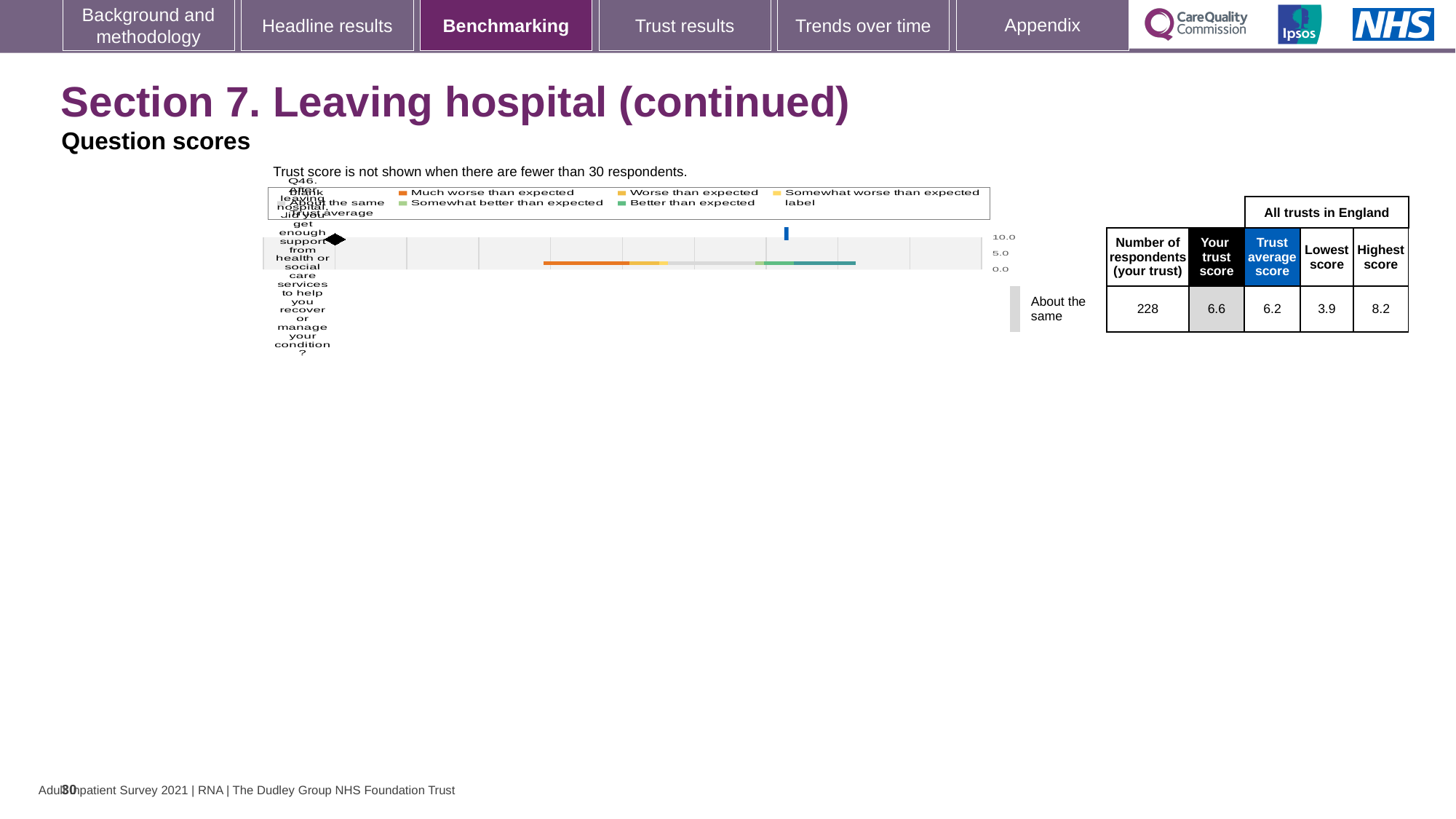
How many respondents from the trust answered Q46? 228 How is the trust's result for Q46 categorised relative to expectations? About the same What is the maximum value shown on the chart's score axis? 10.0 What is the lowest score among all trusts in England for Q46? 3.9 What is the trust score for Q46 (support from health or social care services after leaving hospital)? 6.6 By how much does the trust's score for Q46 exceed the trust average score? 0.4 What is the difference between the highest and lowest scores for Q46 across all trusts in England? 4.3 What is the trust average score across all trusts in England for Q46? 6.2 Is the trust's score for Q46 greater or less than 5.0? greater What kind of chart is used to show the Q46 benchmarking result? Bar chart Which is larger for Q46: the trust's own score or the trust average score? Your trust score What is the highest score among all trusts in England for Q46? 8.2